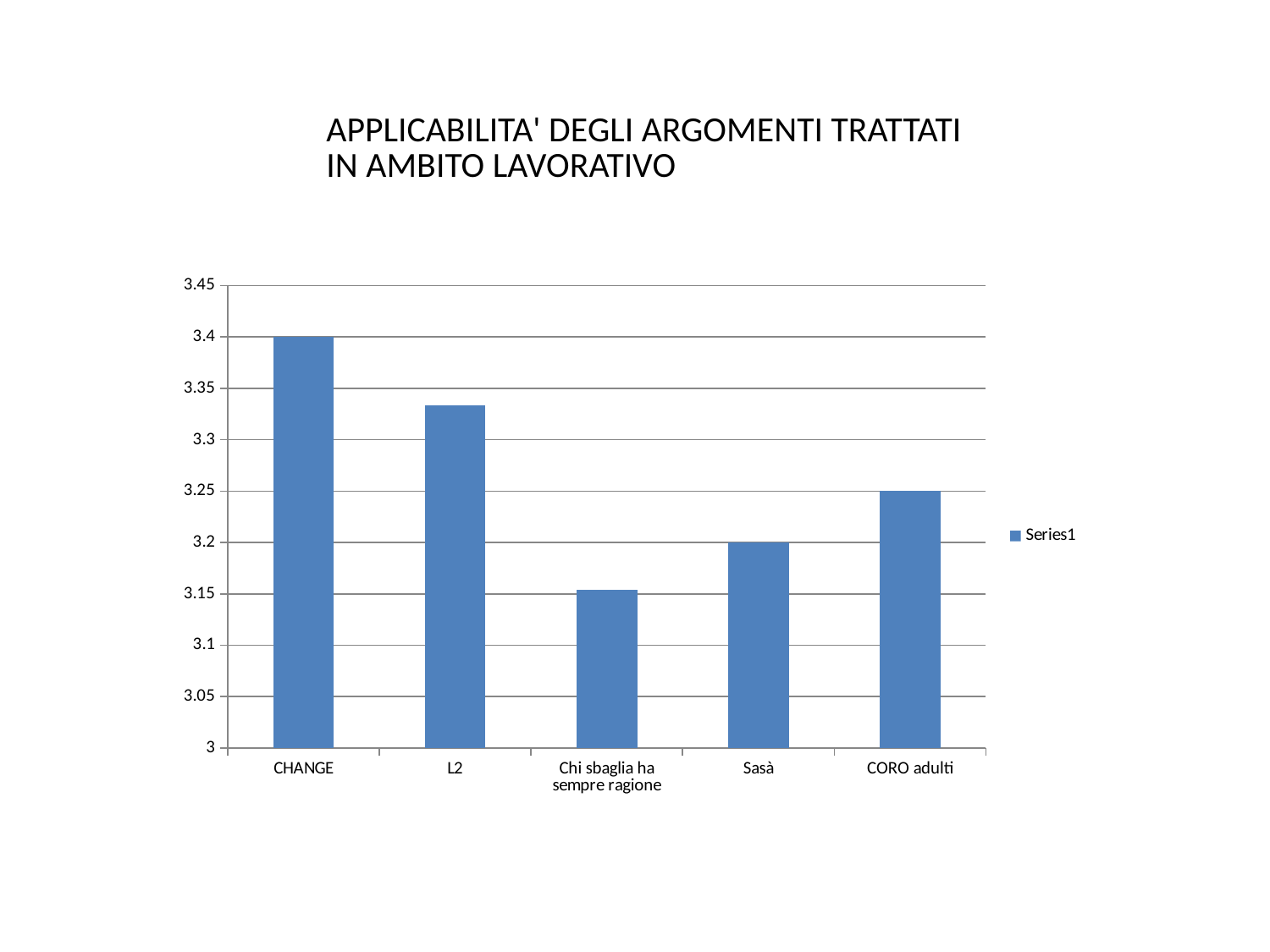
Which category has the lowest value? Chi sbaglia ha sempre ragione Is the value for Chi sbaglia ha sempre ragione greater or less than 3.2? less What is the difference between the values for CHANGE and Sasà? 0.2 How many categories are shown on the x axis of the chart? 5 What type of chart is shown on the slide? bar chart Which category has the highest value? CHANGE What is the value for CORO adulti? 3.25 What is the value for Sasà? 3.2 Is the value for L2 greater or less than 3.3? greater Which is larger, the value for L2 or the value for CORO adulti? L2 How many series does the legend list? 1 What is the value for CHANGE? 3.4